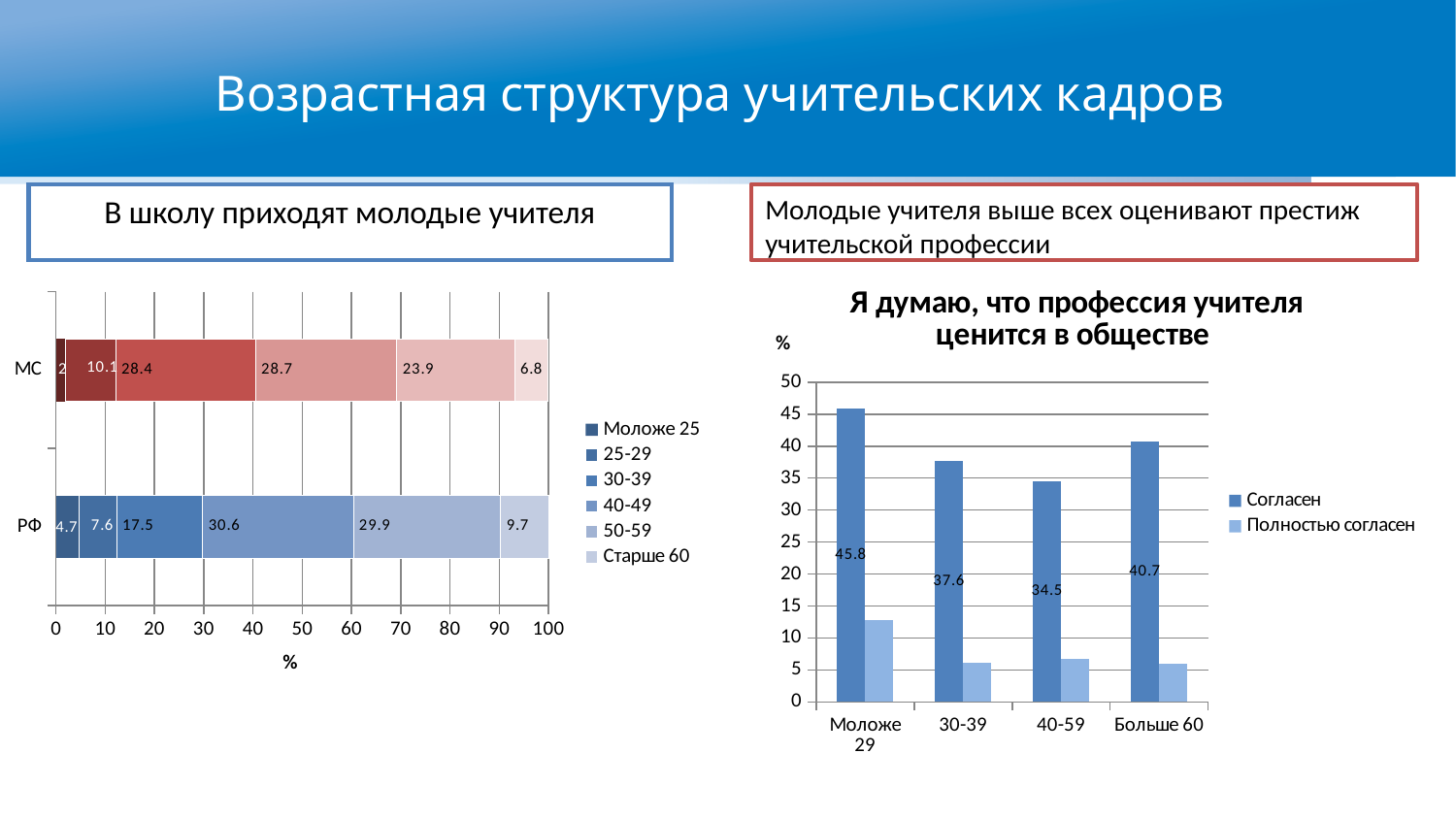
In the left chart, how many series does the legend list? 6 In the chart titled 'Я думаю, что профессия учителя ценится в обществе', which age group has the lowest Согласен value? 40-59 In the chart titled 'Я думаю, что профессия учителя ценится в обществе', what is the Согласен value for 30-39? 37.6 In the left chart, what is the value of the 40-49 series for МС? 28.7 In the chart titled 'Я думаю, что профессия учителя ценится в обществе', is the Полностью согласен value for Моложе 29 greater or less than 10? greater In the chart titled 'Я думаю, что профессия учителя ценится в обществе', which age group has the highest Согласен value? Моложе 29 In the left chart, what is the difference between the 30-39 values for МС and РФ? 10.9 In the left chart, what is the value of the 30-39 series for РФ? 17.5 In the chart titled 'Я думаю, что профессия учителя ценится в обществе', what is the difference between the Согласен values for Моложе 29 and 40-59? 11.3 In the left chart, which age group has the largest share for МС? 40-49 In the left chart, what is the total of the stacked bar for РФ? 100 In the left chart, what is the value of the Старше 60 series for РФ? 9.7